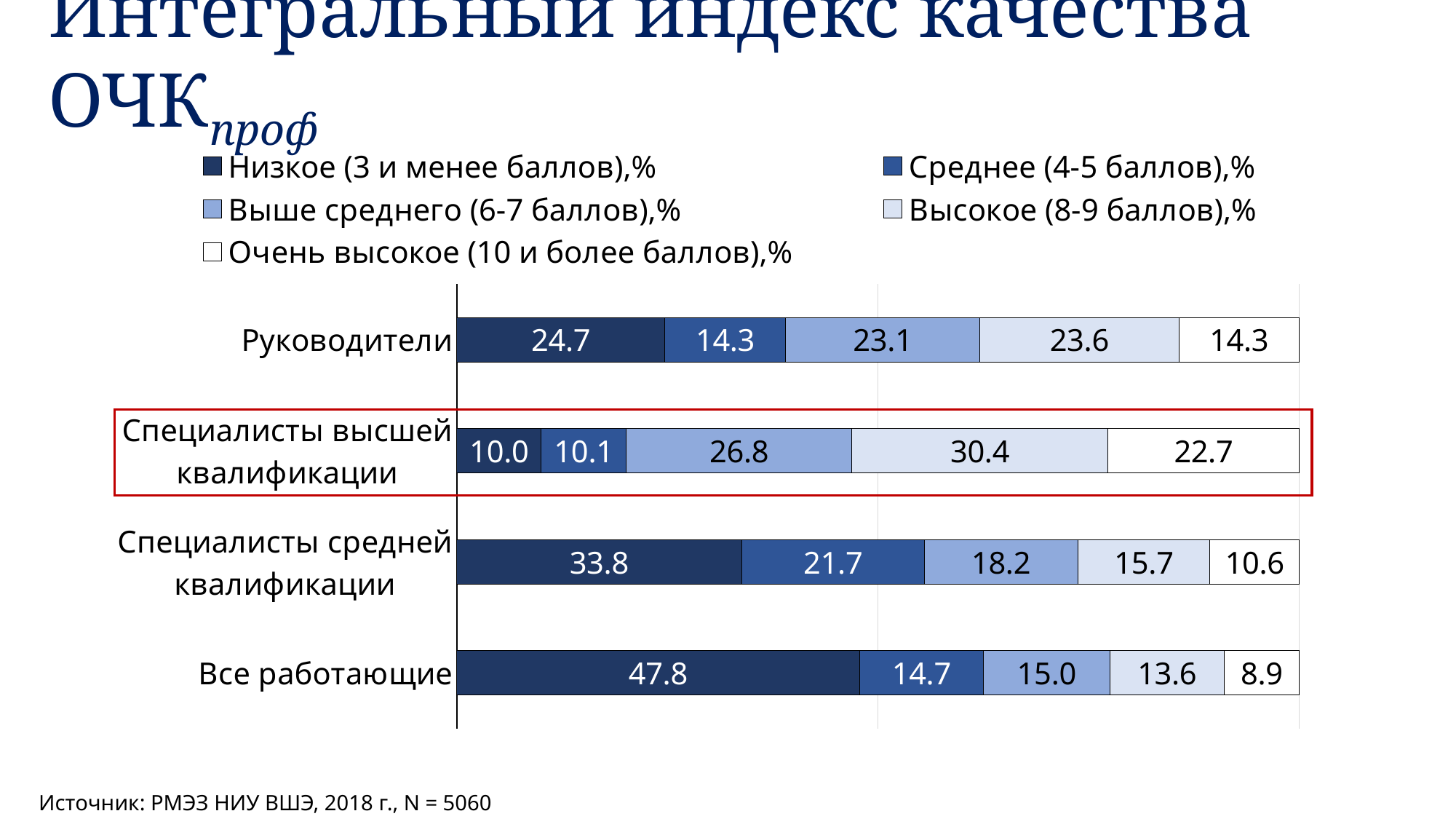
Which category has the highest value for "Низкое (3 и менее баллов),%"? Все работающие What is the difference between the "Низкое (3 и менее баллов),%" values for Все работающие and Руководители? 23.1 What is the total of the stacked bar for Специалисты средней квалификации? 100.0 What is the value of "Высокое (8-9 баллов),%" for Специалисты высшей квалификации? 30.4 Which is larger: the "Очень высокое (10 и более баллов),%" value for Специалисты высшей квалификации or for Специалисты средней квалификации? Специалисты высшей квалификации What is the value of "Среднее (4-5 баллов),%" for Специалисты средней квалификации? 21.7 What kind of chart is shown on the slide? Stacked bar chart How many series does the legend list? 5 What is the value of "Низкое (3 и менее баллов),%" for Все работающие? 47.8 What is the value of "Очень высокое (10 и более баллов),%" for Руководители? 14.3 How many categories (occupational groups) are plotted on the chart? 4 Which category has the lowest value for "Очень высокое (10 и более баллов),%"? Все работающие